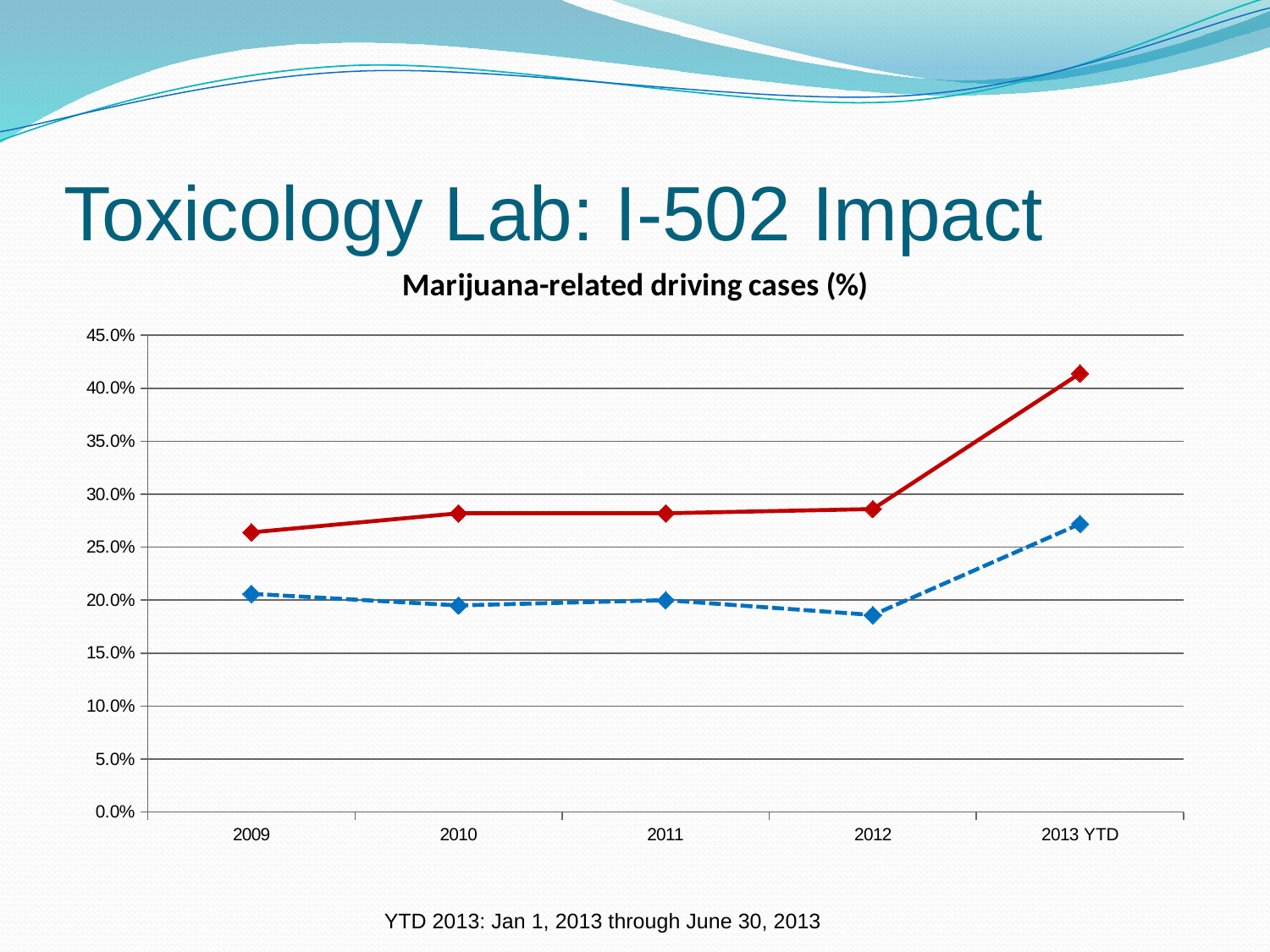
Is the value of the red solid line for 2013 YTD greater or less than 40.0%? greater What is the title of the chart? Marijuana-related driving cases (%) How many categories are shown along the x axis? 5 In 2011, which line has the higher value, the red solid line or the blue dashed line? Red solid line What kind of chart is shown on the slide? Line chart How many lines (series) are plotted on the chart? 2 Is the value of the red solid line for 2009 greater or less than 25.0%? greater For which category does the red solid line reach its highest value? 2013 YTD For which category does the blue dashed line reach its highest value? 2013 YTD Is the value of the blue dashed line for 2012 greater or less than 20.0%? less